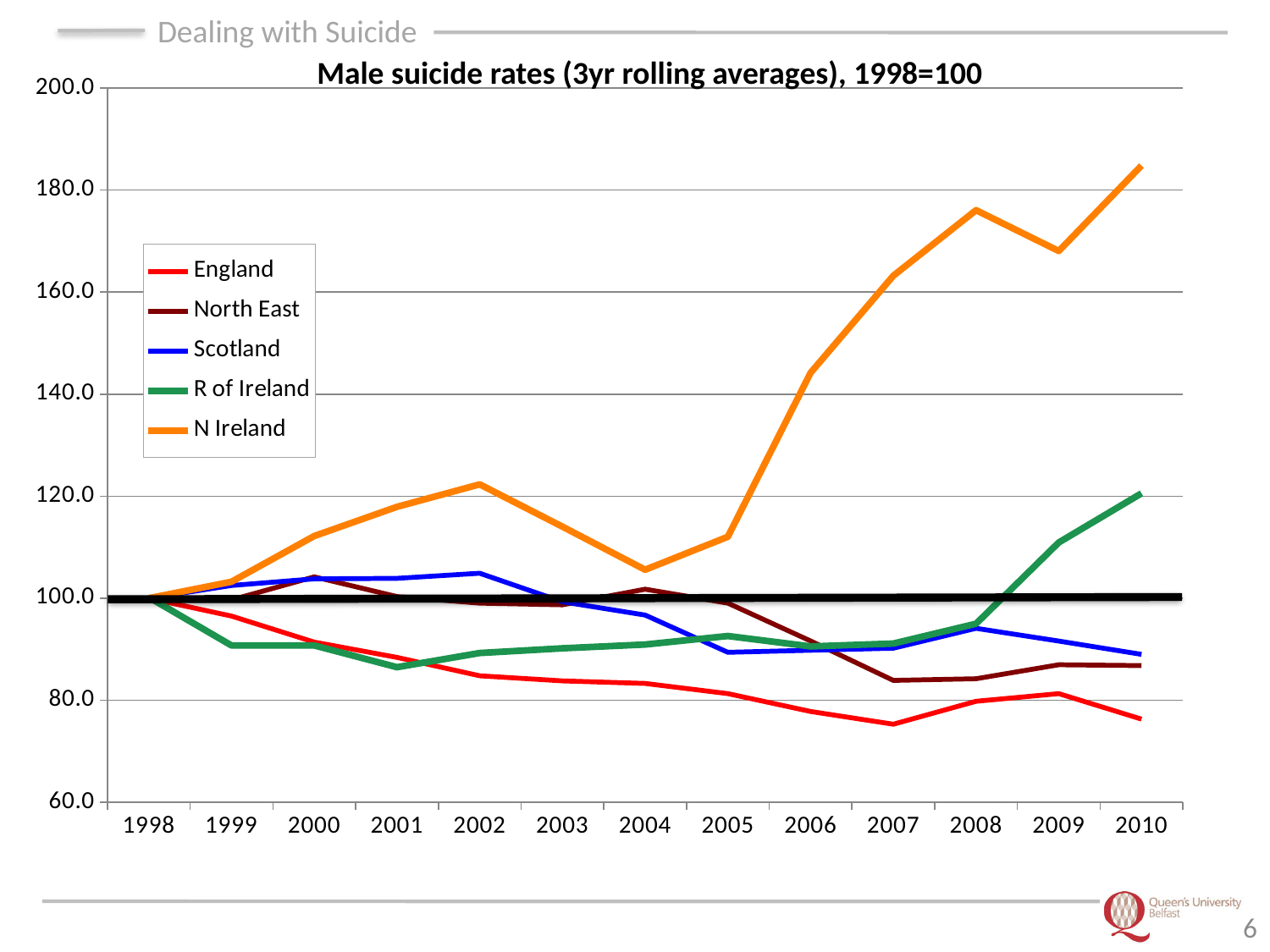
What is the title of the chart? Male suicide rates (3yr rolling averages), 1998=100 Is the value for Scotland in 2010 greater or less than 100? less In 2009, which is larger: the value for R of Ireland or the value for Scotland? R of Ireland How many years are plotted along the x axis? 13 What kind of chart is shown on the slide? line chart Does the N Ireland line rise or fall between 2005 and 2008? rise Which series has the highest value in 2010? N Ireland Is the value for England in 2007 greater or less than 80? less Which series has the lowest value in 2010? England How many series does the legend list? 5 Is the value for N Ireland in 2006 greater or less than 120? greater